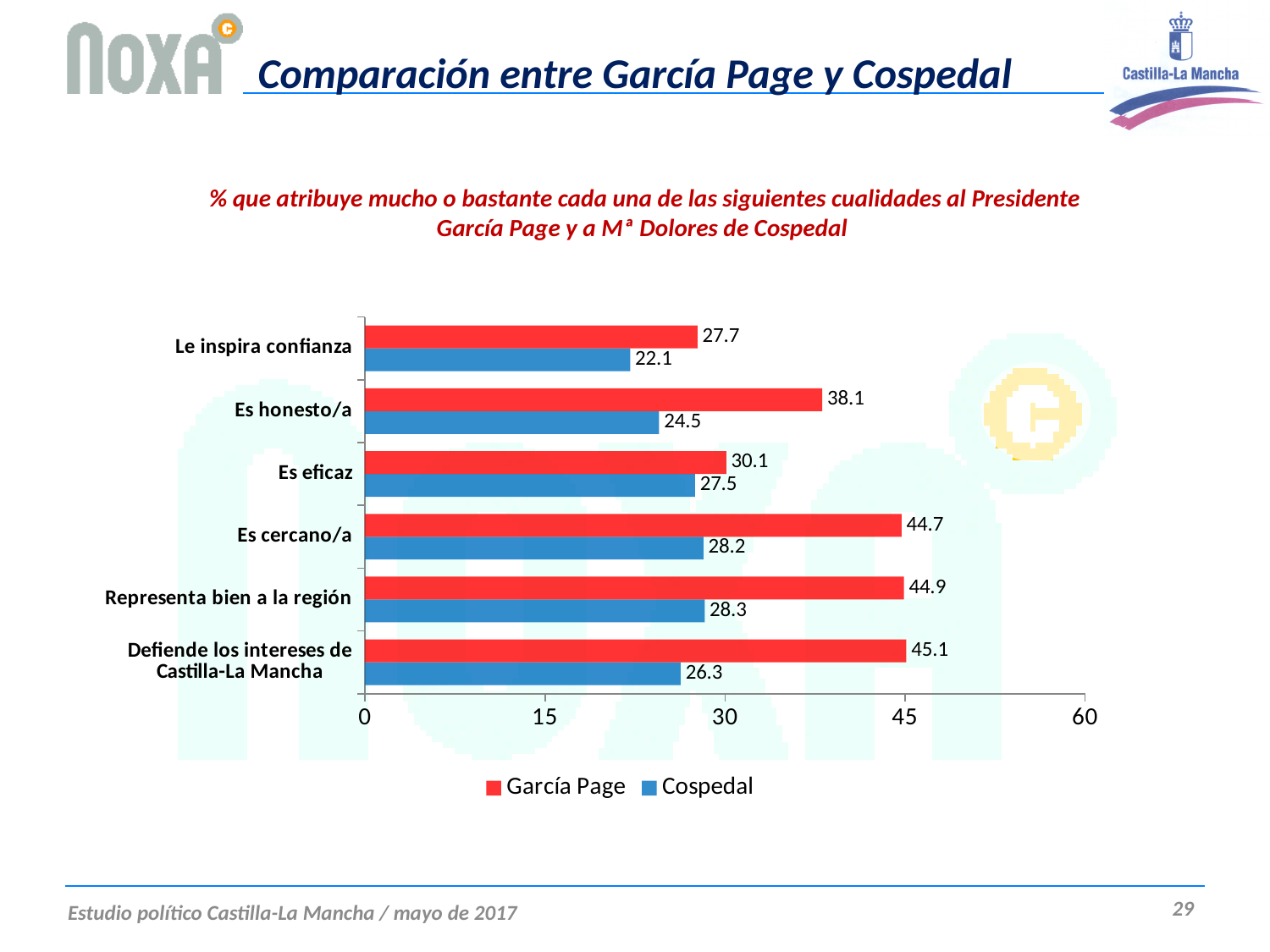
What is the difference between García Page and Cospedal on 'Es honesto/a'? 13.6 What is the difference between García Page and Cospedal on 'Es cercano/a'? 16.5 What is the value for Cospedal on 'Le inspira confianza'? 22.1 What percentage attributes 'Es honesto/a' to García Page? 38.1 For which quality does García Page have the lowest value? Le inspira confianza Who has the higher value on 'Es eficaz', García Page or Cospedal? García Page How many qualities are compared in the chart? 6 Is the value for Cospedal on 'Es eficaz' greater or less than 30? less What is the value for Cospedal on 'Es cercano/a'? 28.2 How many series does the legend list? 2 What is the value for García Page on 'Defiende los intereses de Castilla-La Mancha'? 45.1 For which quality does Cospedal have the lowest value? Le inspira confianza